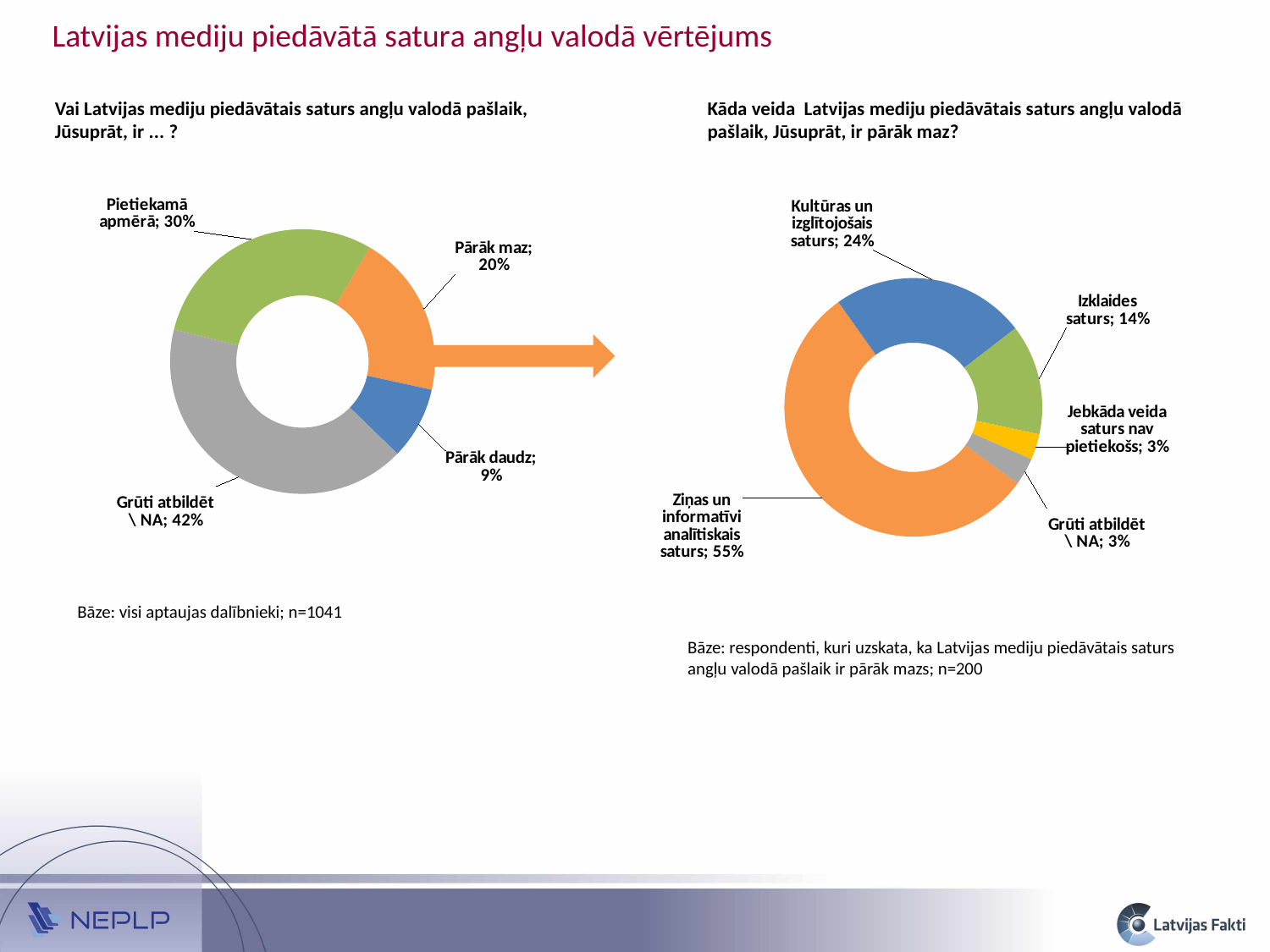
In the left chart, what share of respondents answered "Pietiekamā apmērā"? 30% In the right chart, which category has the largest share? Ziņas un informatīvi analītiskais saturs What type of chart is used on the left side of the slide? Pie (doughnut) chart In the right chart, what share is "Izklaides saturs"? 14% In the right chart, what share is "Ziņas un informatīvi analītiskais saturs"? 55% How many categories does the right chart show? 5 How many categories does the left chart show? 4 In the right chart, which is larger: "Kultūras un izglītojošais saturs" or "Izklaides saturs"? Kultūras un izglītojošais saturs In the left chart, what is the difference in percentage points between "Pietiekamā apmērā" and "Pārāk maz"? 10 In the left chart, which category has the smallest share? Pārāk daudz In the left chart, what share of respondents answered "Pārāk daudz"? 9% In the left chart, which category has the largest share? Grūti atbildēt \ NA